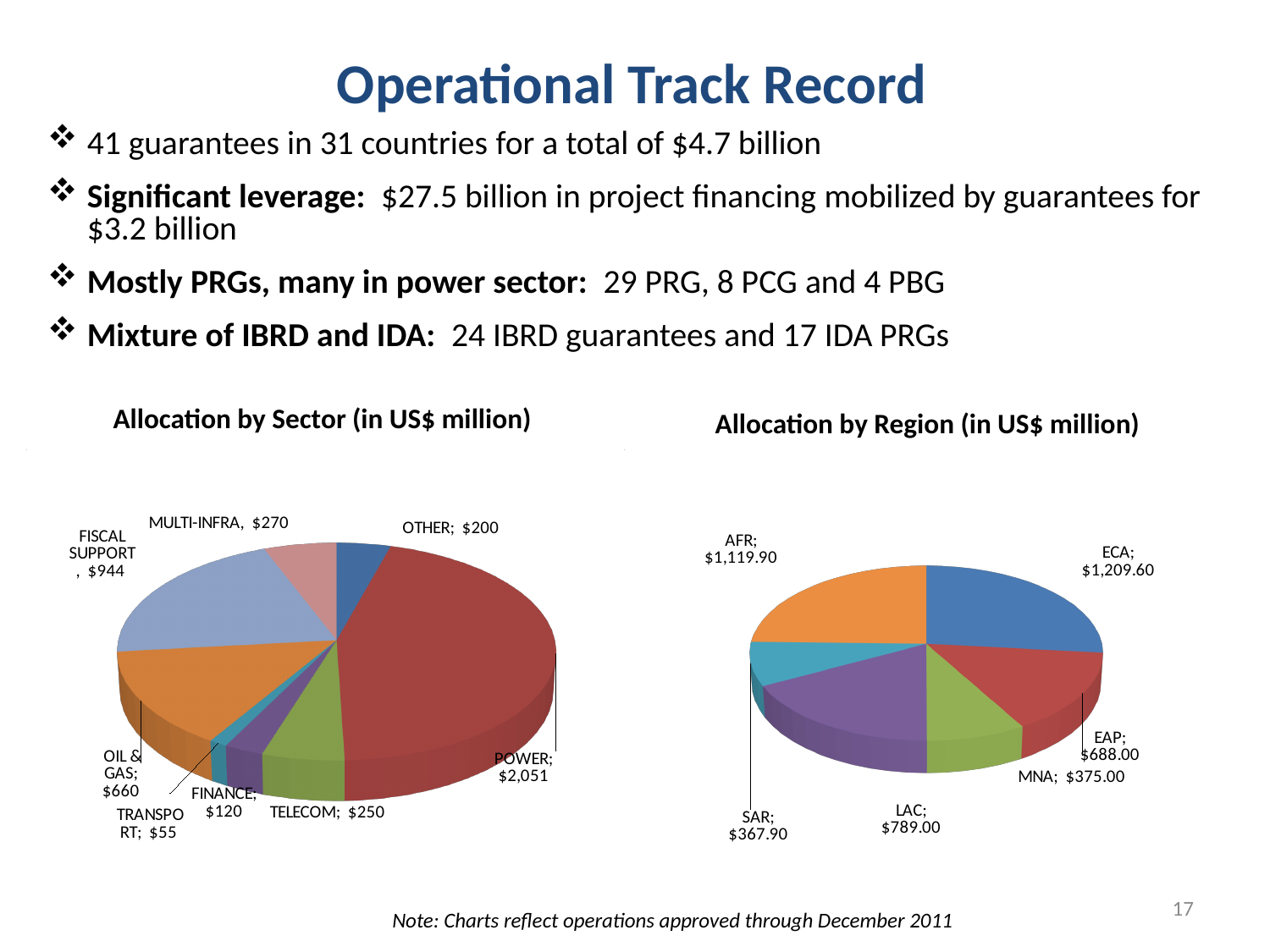
How many sectors are shown in the Allocation by Sector chart? 8 In the Allocation by Sector chart, which sector has the largest allocation? POWER In the Allocation by Sector chart, which sector has the smallest allocation? TRANSPORT What type of chart is the Allocation by Region chart? Pie chart In the Allocation by Region chart, what is the value for SAR? $367.90 In the Allocation by Region chart, which is larger, EAP or MNA? EAP In the Allocation by Sector chart, what is the value for POWER? $2,051 In the Allocation by Region chart, which region has the largest allocation? ECA In the Allocation by Region chart, what is the value for LAC? $789.00 In the Allocation by Sector chart, what is the difference between OIL & GAS and TELECOM? $410 In the Allocation by Region chart, which region has the smallest allocation? SAR In the Allocation by Sector chart, what is the value for FISCAL SUPPORT? $944